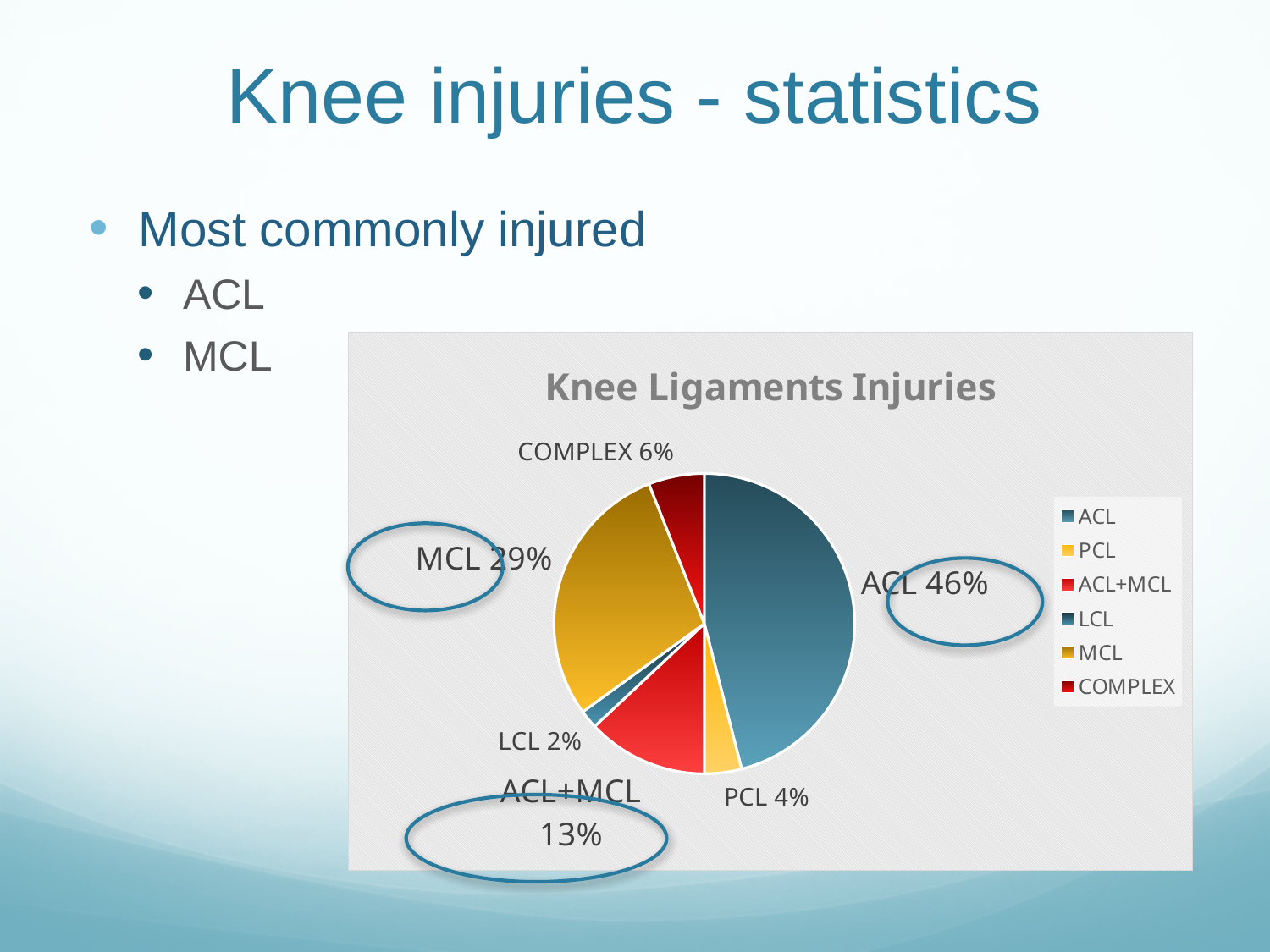
How many categories does the legend list? 6 What type of chart is shown on the slide? pie chart What is the difference in percentage points between ACL and MCL injuries? 17 Which category has the largest share of the pie? ACL What is the title of the chart? Knee Ligaments Injuries Which is larger, the share for COMPLEX or the share for PCL? COMPLEX What percentage of knee ligament injuries is attributed to MCL? 29% What percentage is shown for ACL+MCL injuries? 13% What percentage of knee ligament injuries is attributed to ACL? 46% What percentage is shown for PCL injuries? 4% What percentage is shown for COMPLEX injuries? 6% Which category has the smallest share of the pie? LCL